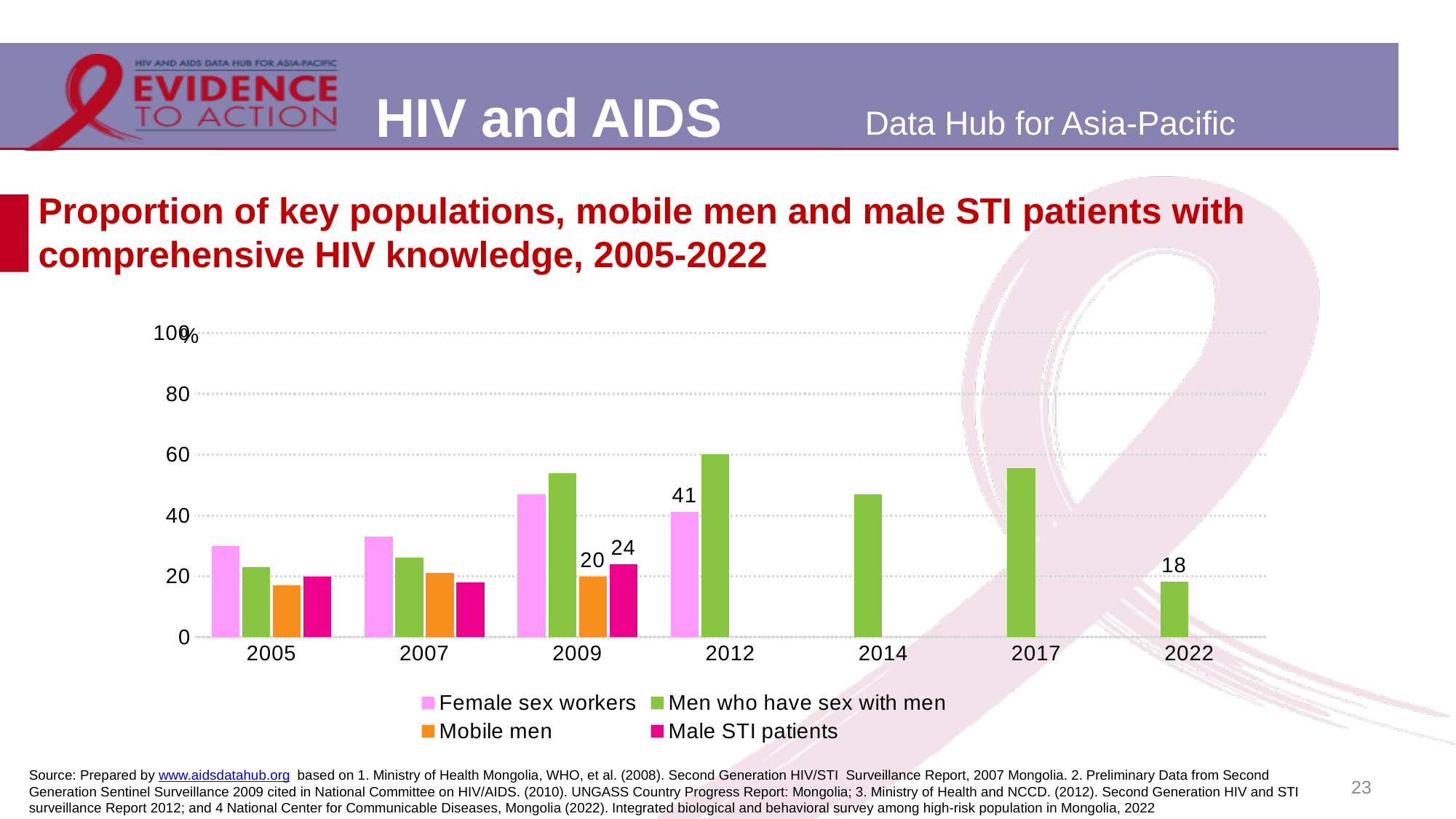
Is the value for Men who have sex with men in 2017 greater or less than 40? greater What kind of chart is shown on the slide? bar chart Is the value for Female sex workers in 2005 greater or less than 40? less In 2009, which is larger: the value for Male STI patients or for Mobile men? Male STI patients How many series does the legend list? 4 In 2009, what is the difference between the values for Male STI patients and Mobile men? 4 What is the value for Mobile men in 2009? 20 What is the value for Male STI patients in 2009? 24 In which year is the value for Men who have sex with men lowest? 2022 How many years are shown on the x axis? 7 What is the value for Female sex workers in 2012? 41 What is the value for Men who have sex with men in 2022? 18